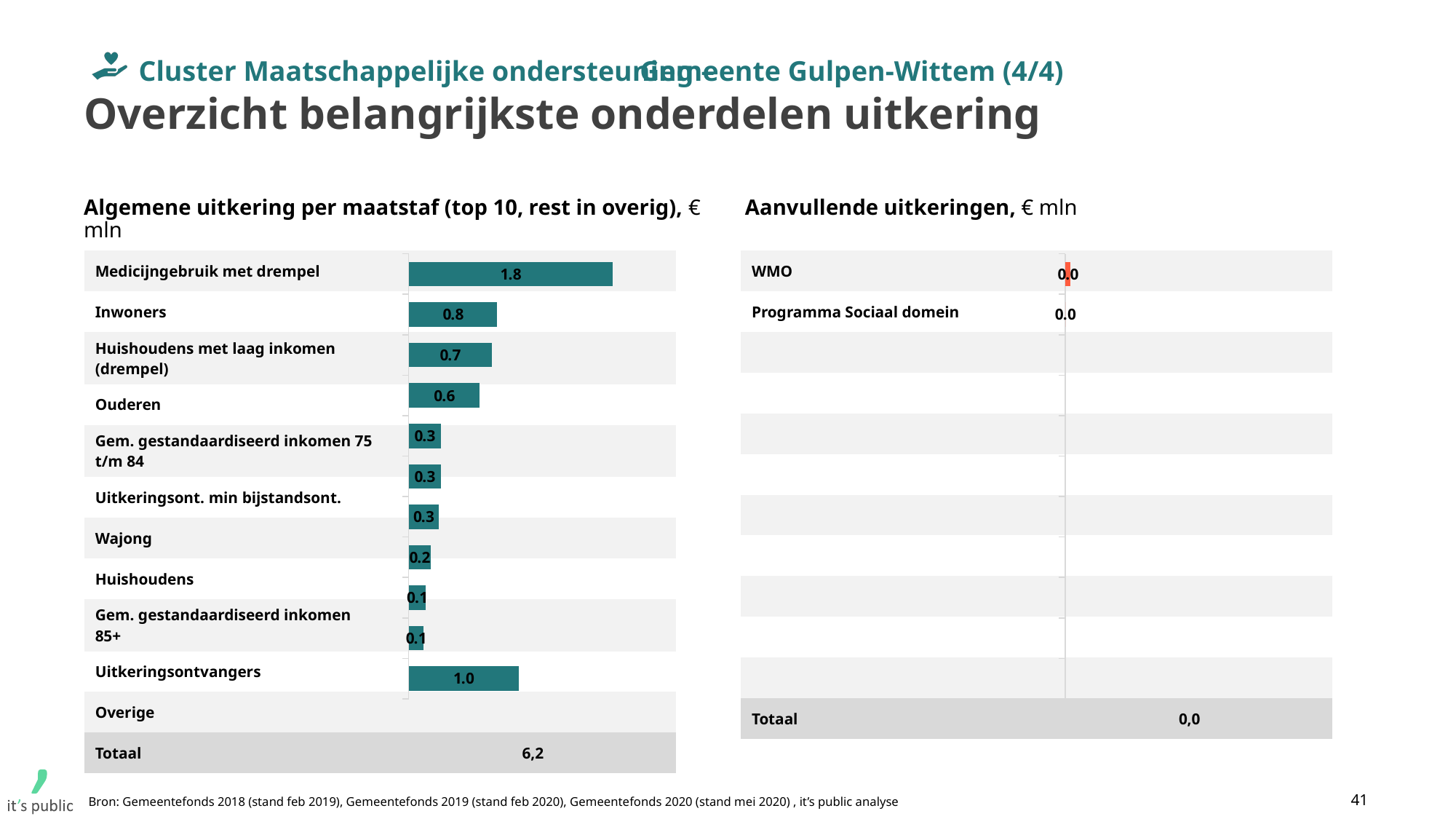
In the chart 'Aanvullende uitkeringen', what is the Totaal shown? 0,0 In the chart 'Algemene uitkering per maatstaf', what is the value for Overige? 1.0 In the chart 'Algemene uitkering per maatstaf', what is the value for Inwoners? 0.8 What kind of chart is 'Algemene uitkering per maatstaf'? Bar chart In the chart 'Algemene uitkering per maatstaf', which is larger: Huishoudens met laag inkomen (drempel) or Ouderen? Huishoudens met laag inkomen (drempel) In the chart 'Aanvullende uitkeringen', how many categories are listed (excluding Totaal)? 2 In the chart 'Algemene uitkering per maatstaf', what is the Totaal shown? 6,2 In the chart 'Algemene uitkering per maatstaf', which category has the highest value? Medicijngebruik met drempel In the chart 'Algemene uitkering per maatstaf', what is the difference between Medicijngebruik met drempel and Inwoners? 1.0 What unit is stated in the title of the chart 'Aanvullende uitkeringen'? € mln In the chart 'Algemene uitkering per maatstaf', what is the value for Medicijngebruik met drempel? 1.8 In the chart 'Aanvullende uitkeringen', what is the value for WMO? 0.0